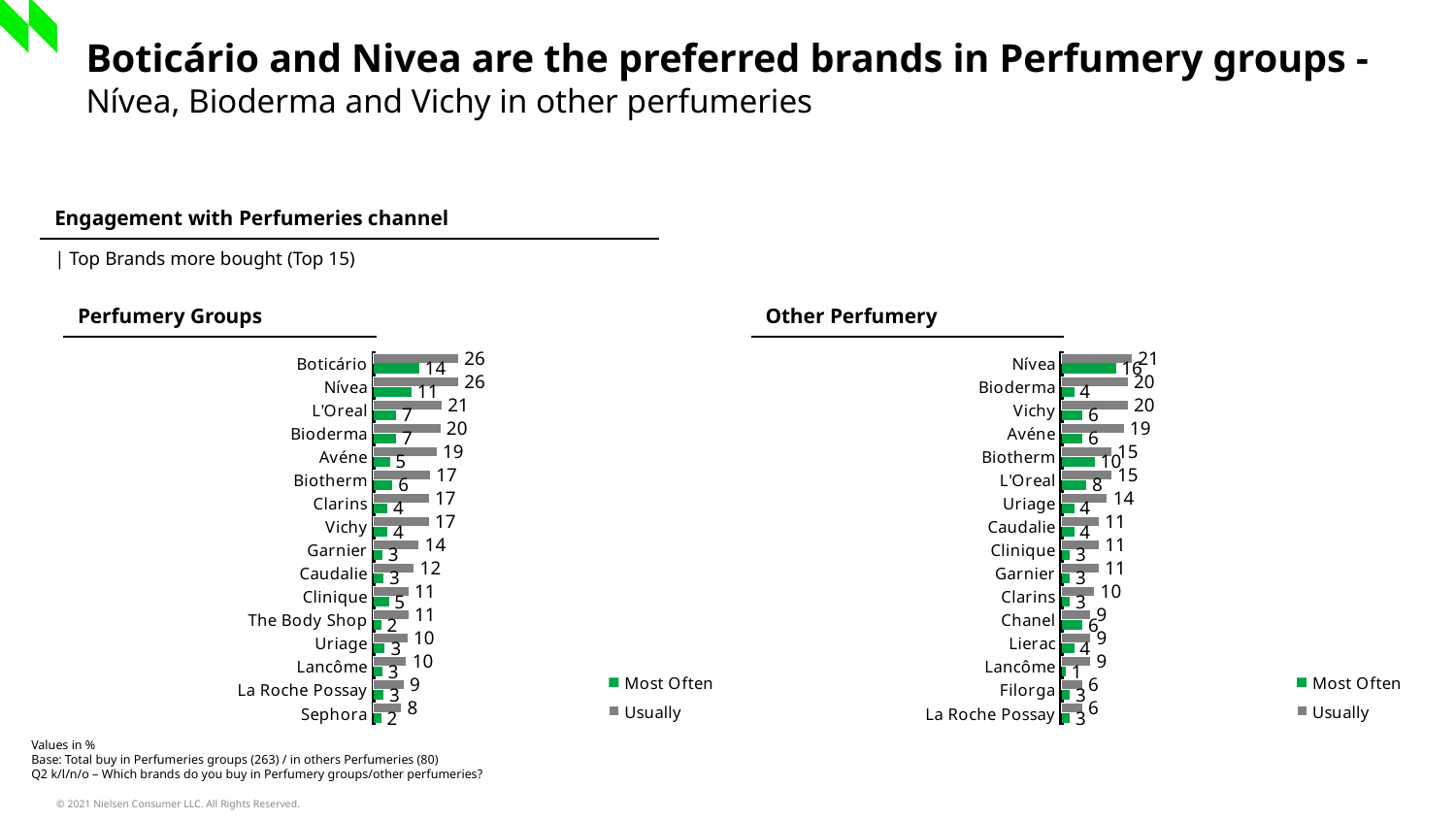
In the Other Perfumery chart, what is the Usually value for Biotherm? 15 In the Perfumery Groups chart, what is the Most Often value for Nívea? 11 In the Perfumery Groups chart, what is the Usually value for Boticário? 26 In the Other Perfumery chart, which brand has the lowest Most Often value? Lancôme What kind of chart is the Perfumery Groups chart? Bar chart In the Perfumery Groups chart, what is the difference between the Usually values for L'Oreal and Sephora? 13 In the Other Perfumery chart, what is the Most Often value for Nívea? 16 In the Other Perfumery chart, which is larger, the Most Often value for Biotherm or for L'Oreal? Biotherm How many series does the legend of the Other Perfumery chart list? 2 In the Perfumery Groups chart, which brand has the highest Most Often value? Boticário In the Perfumery Groups chart, which colour represents the Most Often series? Green In the Other Perfumery chart, what is the difference between the Usually and Most Often values for Bioderma? 16